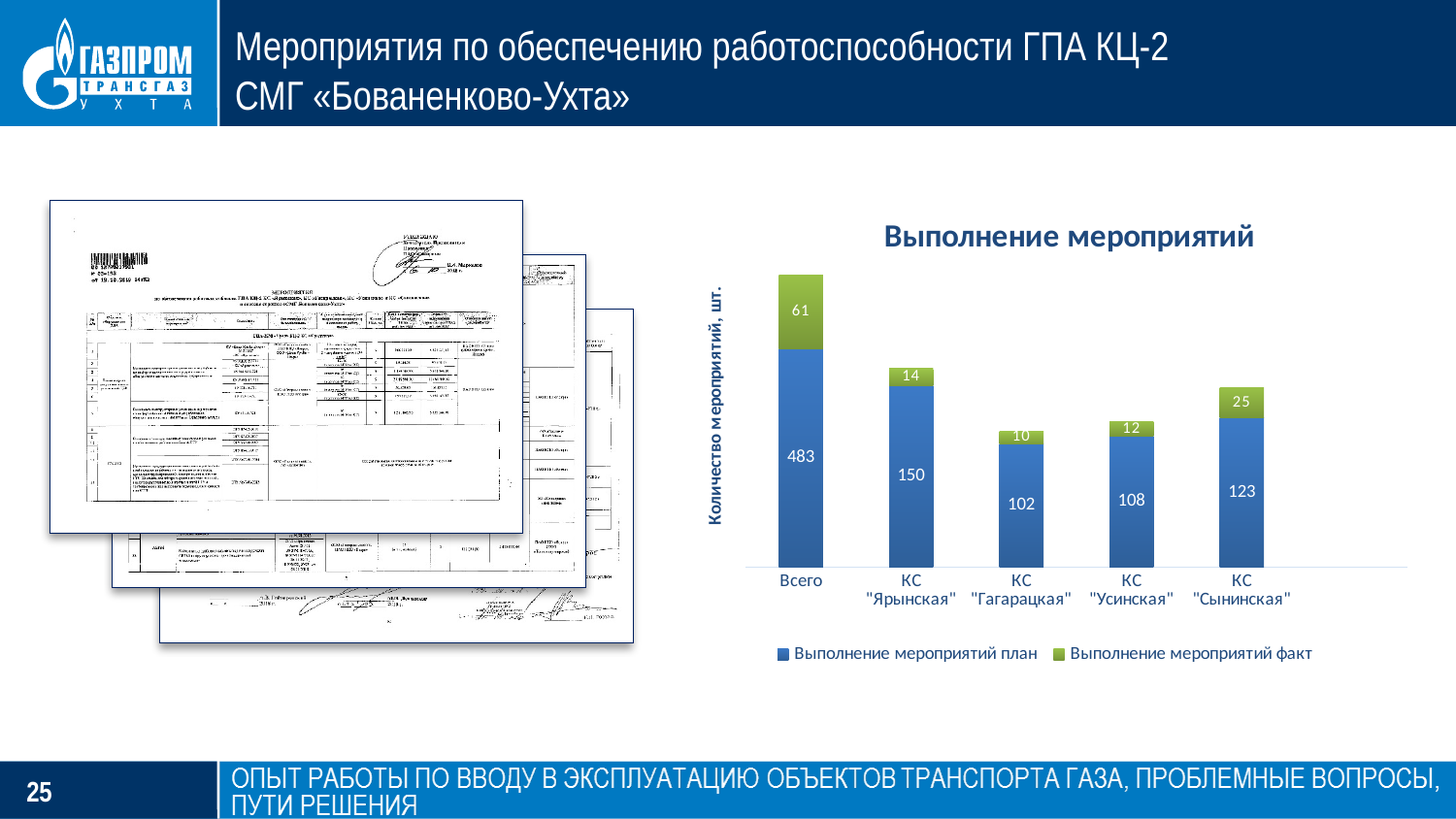
What is the planned value (Выполнение мероприятий план) for КС "Ярынская"? 150 What is the total of the stacked bar for Всего (план plus факт)? 544 Which is larger: the actual value for КС "Усинская" or for КС "Гагарацкая"? КС "Усинская" What is the actual value (Выполнение мероприятий факт) for КС "Сынинская"? 25 What is the planned value (Выполнение мероприятий план) for Всего? 483 Which compressor station (КС) has the lowest planned value (Выполнение мероприятий план)? КС "Гагарацкая" Which compressor station (КС) has the highest actual value (Выполнение мероприятий факт)? КС "Сынинская" What type of chart is shown on the slide? Stacked bar chart What is the title of the chart? Выполнение мероприятий What is the difference between the planned values for КС "Ярынская" and КС "Усинская"? 42 How many categories are shown on the x axis of the chart? 5 How many series does the chart legend list? 2